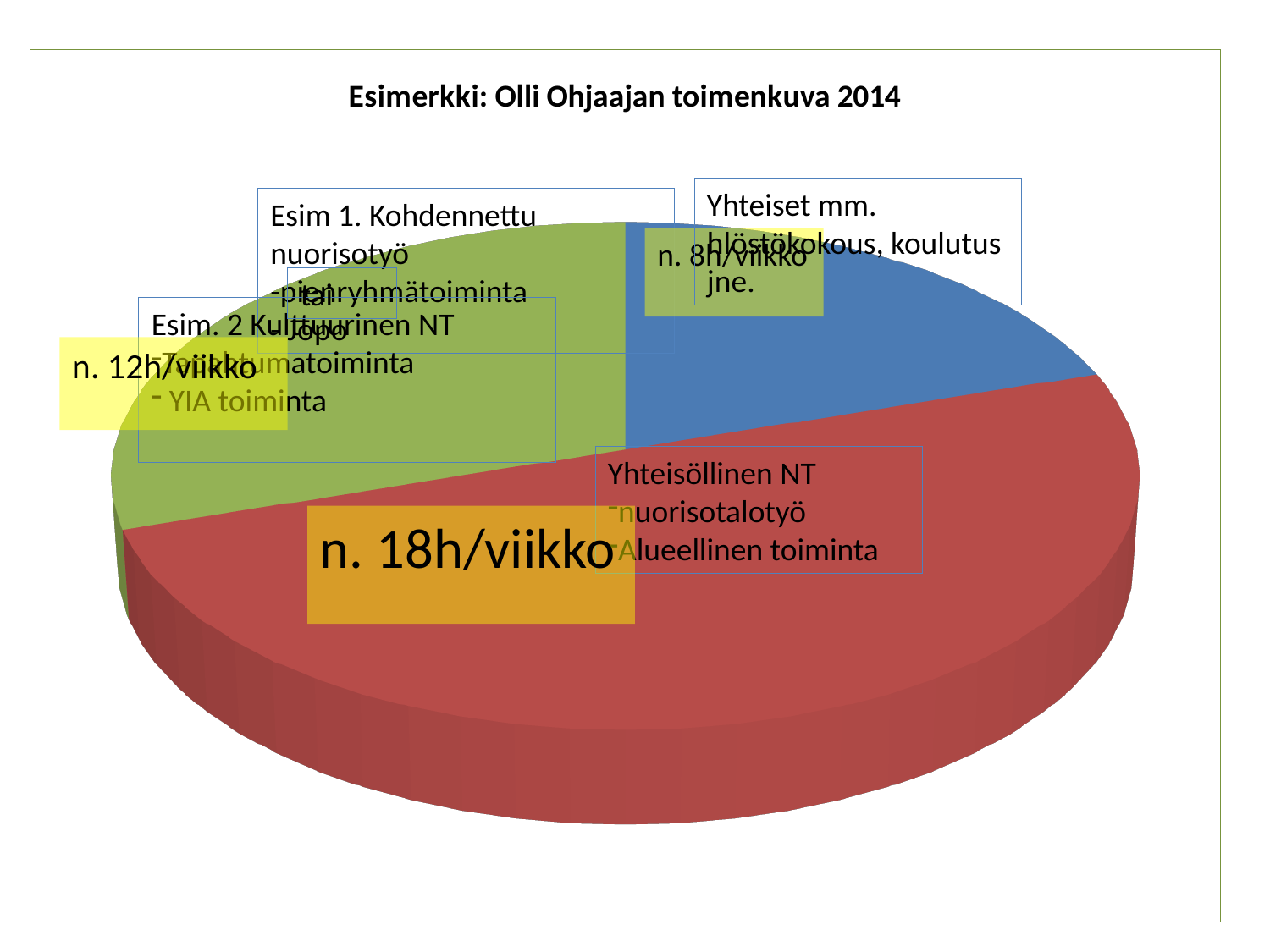
Which slice of the pie chart is the largest? Yhteisöllinen NT What kind of chart is shown on the slide? pie chart Which is larger: the Kohdennettu nuorisotyö slice or the Yhteiset slice? Kohdennettu nuorisotyö What weekly hours label is shown for the Yhteiset slice? n. 8h/viikko What weekly hours label is shown for the Kohdennettu nuorisotyö / Kulttuurinen NT slice? n. 12h/viikko How many slices does the pie chart have? 3 Which slice of the pie chart is the smallest? Yhteiset What weekly hours label is shown for the Yhteisöllinen NT slice? n. 18h/viikko What is the title of the chart? Esimerkki: Olli Ohjaajan toimenkuva 2014 Which is larger: the Yhteisöllinen NT slice or the Yhteiset slice? Yhteisöllinen NT What colour is the Yhteisöllinen NT slice? red